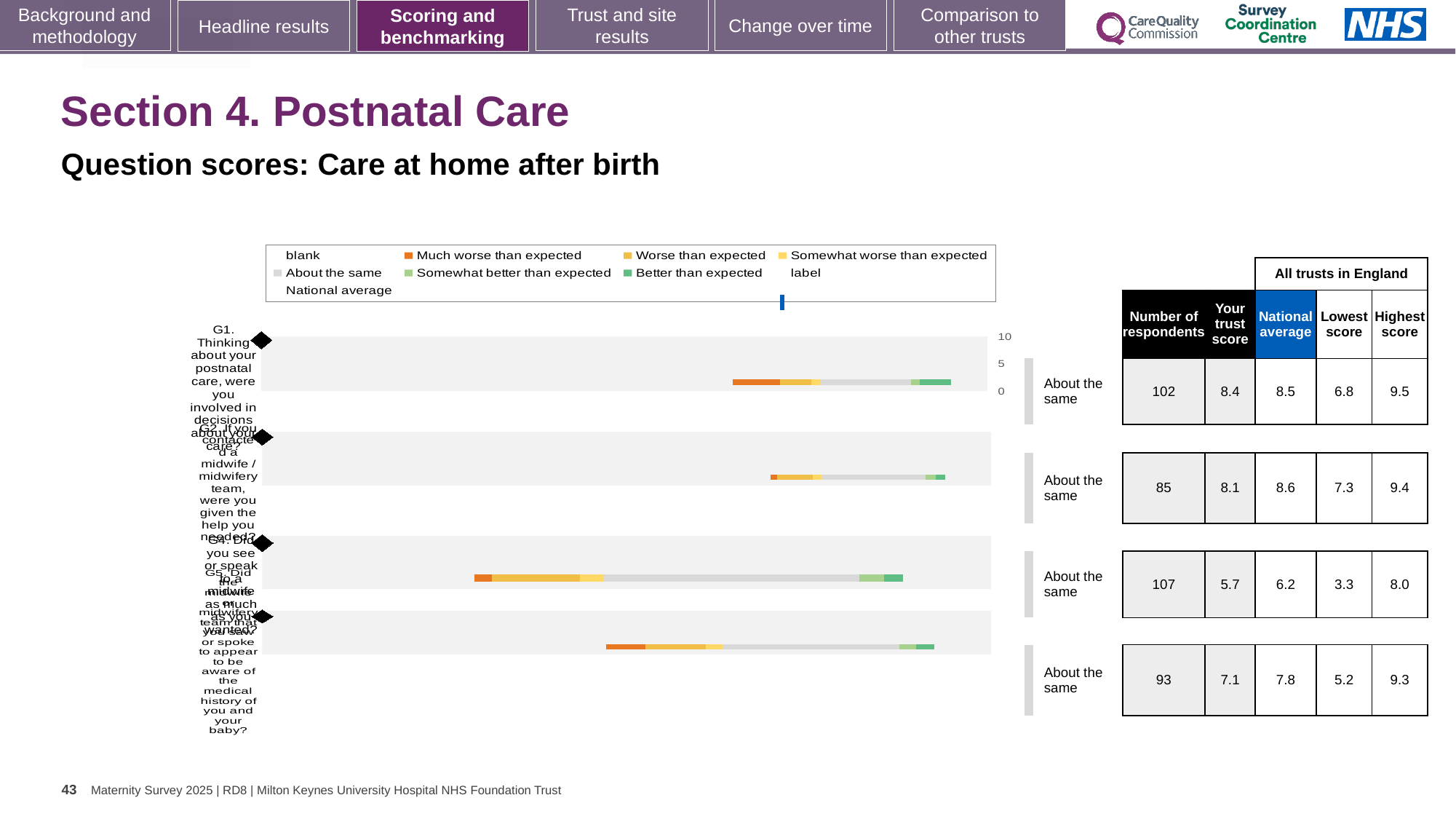
What is the highest score in England for the bottom row? 9.3 What is the difference between the national average and the trust score for the third row (6.2 vs 5.7)? 0.5 Which is larger: the lowest score for the second row or the lowest score for the bottom row? The second row (7.3) What kind of chart is shown on the slide? Bar chart How many of the four rows are rated 'About the same'? 4 Which row has the highest 'Your trust score'? The top row (G1), 8.4 What is the national average for the second row (G2)? 8.6 What is the subtitle describing the chart's question scores? Question scores: Care at home after birth How many question bars are plotted in the chart? 4 What is the 'Your trust score' value for the top row (G1)? 8.4 In the table beside the chart, what is the number of respondents for the top row (G1)? 102 Which row has the lowest 'Your trust score'? The third row (G4), 5.7